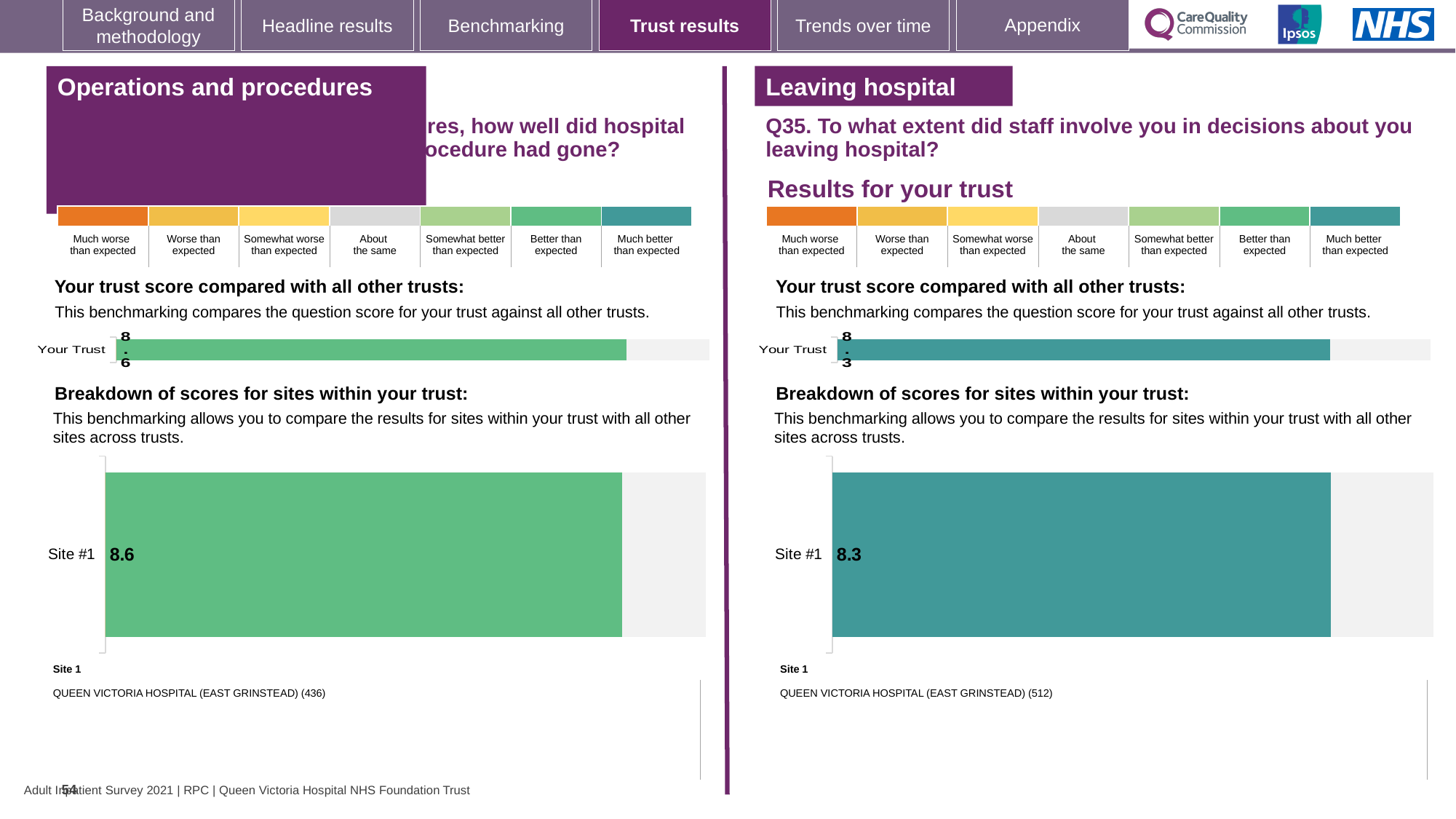
What is the difference between the Site #1 score in the 'Operations and procedures' section and the Site #1 score in the 'Leaving hospital' section? 0.3 Which question number is shown above the charts in the 'Leaving hospital' section? Q35 What kind of chart is used to show the Site #1 score in the 'Leaving hospital' section? Bar chart On the 'Operations and procedures' section, what is the 'Your Trust' score in the trust comparison chart? 8.6 Which Site #1 score is larger: the one in the 'Operations and procedures' section or the one in the 'Leaving hospital' section? Operations and procedures How many bars are plotted in the 'Your trust score compared with all other trusts' chart in the 'Leaving hospital' section? 1 How many sites are plotted in the 'Breakdown of scores for sites within your trust' chart in the 'Operations and procedures' section? 1 On the 'Leaving hospital' section, what is the 'Your Trust' score in the trust comparison chart? 8.3 On the 'Operations and procedures' section, what is the score shown for Site #1? 8.6 On the 'Leaving hospital' section, what is the score shown for Site #1? 8.3 Which site name is listed as Site 1 in the 'Leaving hospital' section? QUEEN VICTORIA HOSPITAL (EAST GRINSTEAD) (512)